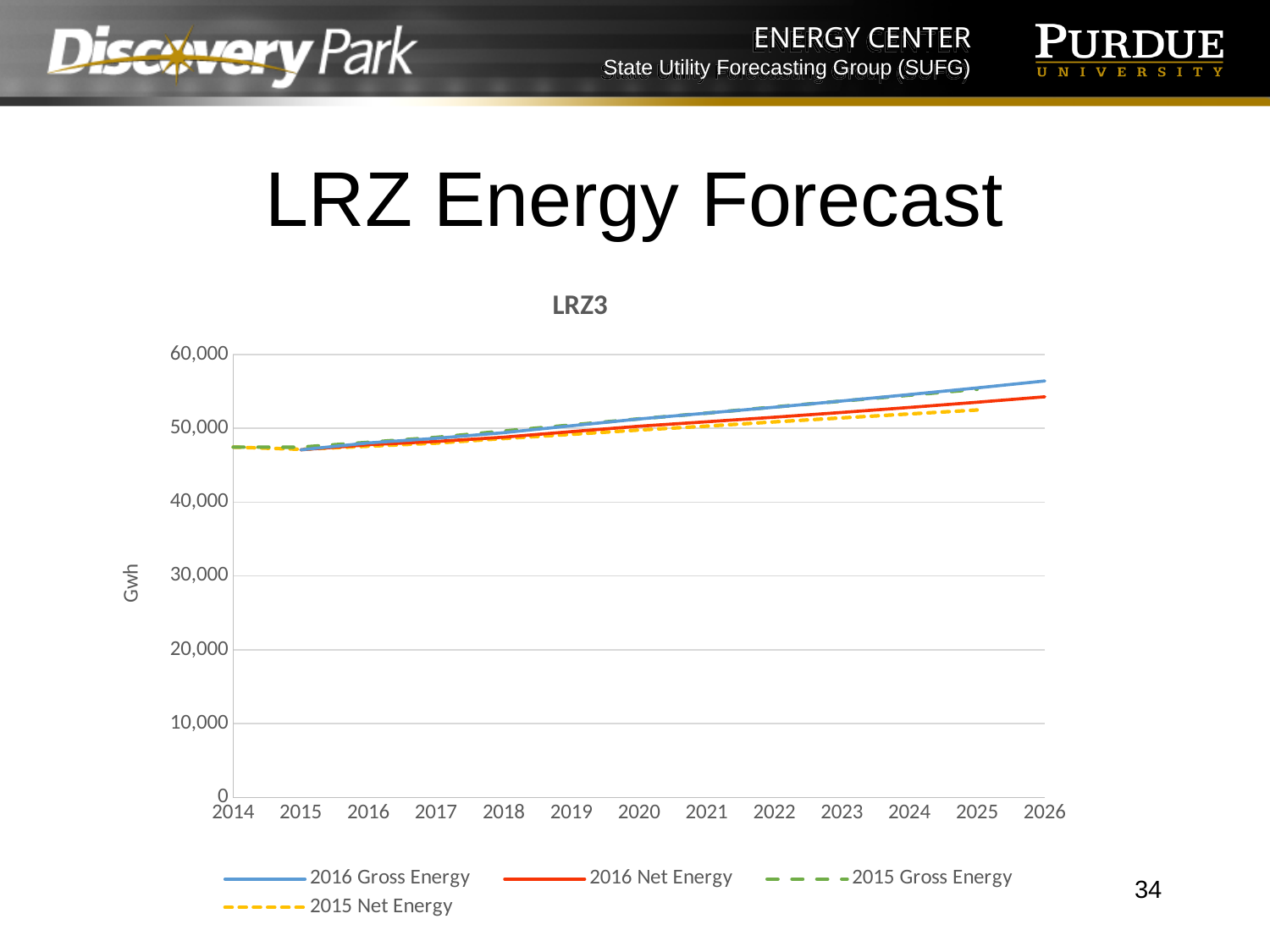
Which series reaches the highest value at the right end of the chart (2026)? 2016 Gross Energy Do the 2016 Gross Energy values rise or fall from 2015 to 2026? rise How many series does the legend list? 4 What kind of chart is shown on the slide? line chart What unit is shown on the y-axis label? Gwh Is the value for 2016 Gross Energy in 2026 greater or less than 50,000? greater In 2026, which is larger: 2016 Gross Energy or 2016 Net Energy? 2016 Gross Energy How many years are marked on the x axis? 13 Is the value for 2015 Net Energy in 2025 greater or less than 50,000? greater What is the title of the chart? LRZ3 Is the value for 2016 Gross Energy in 2026 greater or less than 60,000? less